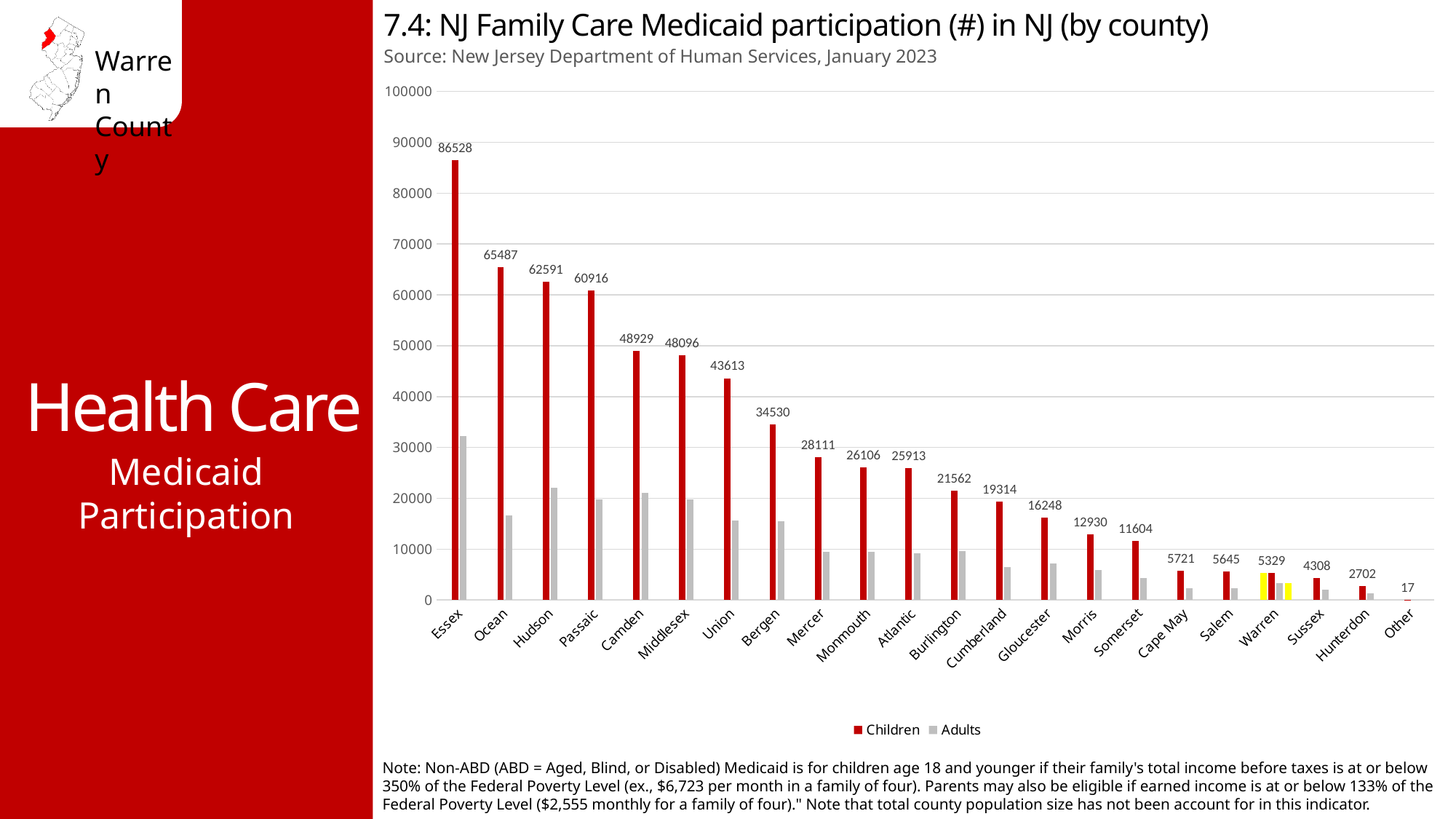
Is the Adults value for Ocean greater or less than 20000? less Which county has the highest Children value? Essex Which has a larger Children value, Camden or Middlesex? Camden How many series does the legend list? 2 What kind of chart is shown on the slide? Bar chart What is the Children value for Warren? 5329 Which category has the lowest Children value? Other What is the difference between the Children values for Ocean and Hudson? 2896 Is the Adults value for Essex greater or less than 30000? greater What is the Children value for Hunterdon? 2702 What is the Children value for Essex? 86528 How many categories are shown on the x axis? 22